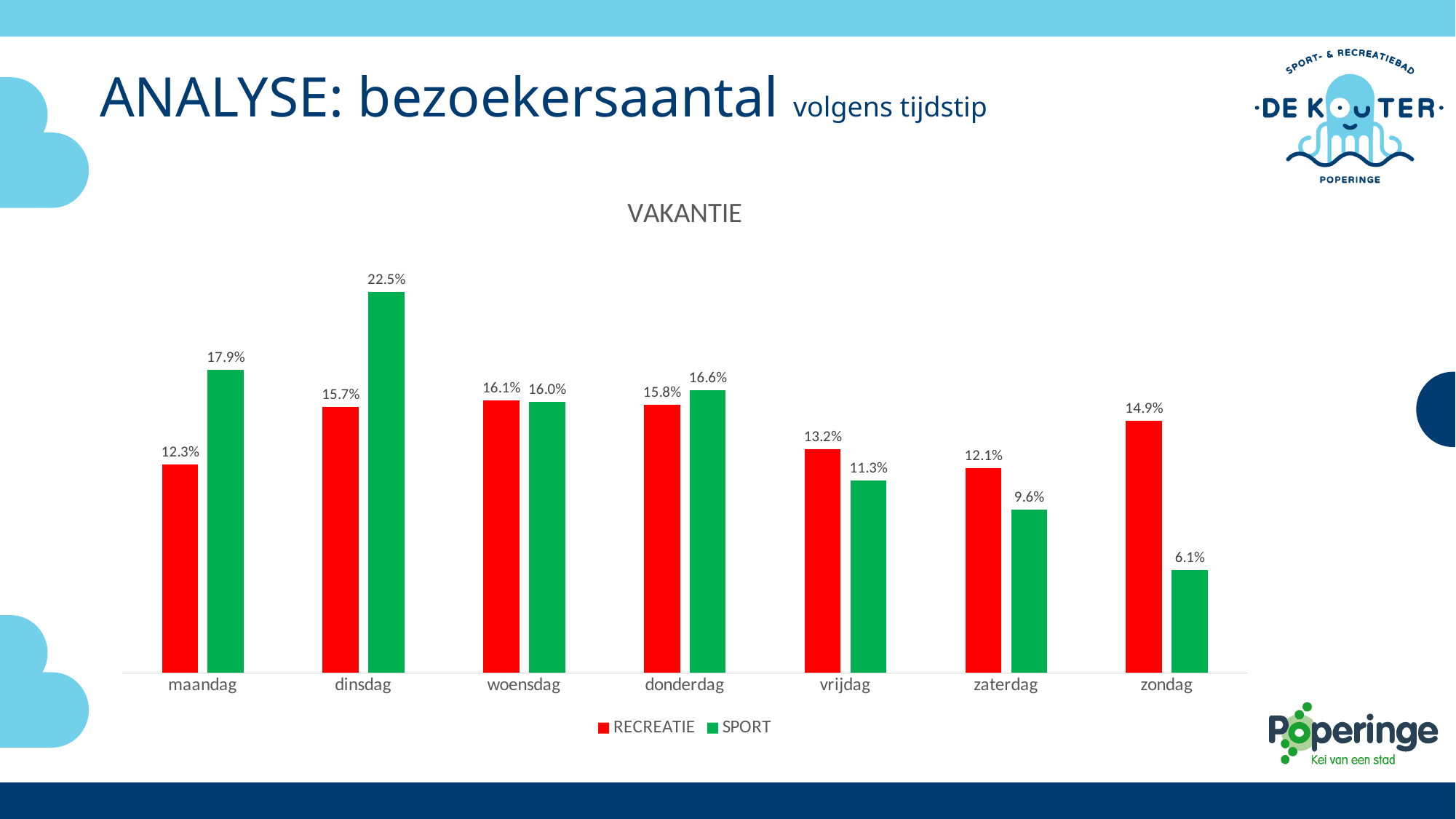
What is the difference between the SPORT and RECREATIE values for zondag? 8.8% Which is larger on zaterdag, RECREATIE or SPORT? RECREATIE What kind of chart is shown? bar chart What is the SPORT value for zondag? 6.1% What is the RECREATIE value for maandag? 12.3% How many days are shown on the x axis? 7 What is the RECREATIE value for vrijdag? 13.2% What is the title of the chart? VAKANTIE Which day has the lowest RECREATIE value? zaterdag How many series does the legend list? 2 What is the SPORT value for dinsdag? 22.5% Which day has the highest SPORT value? dinsdag